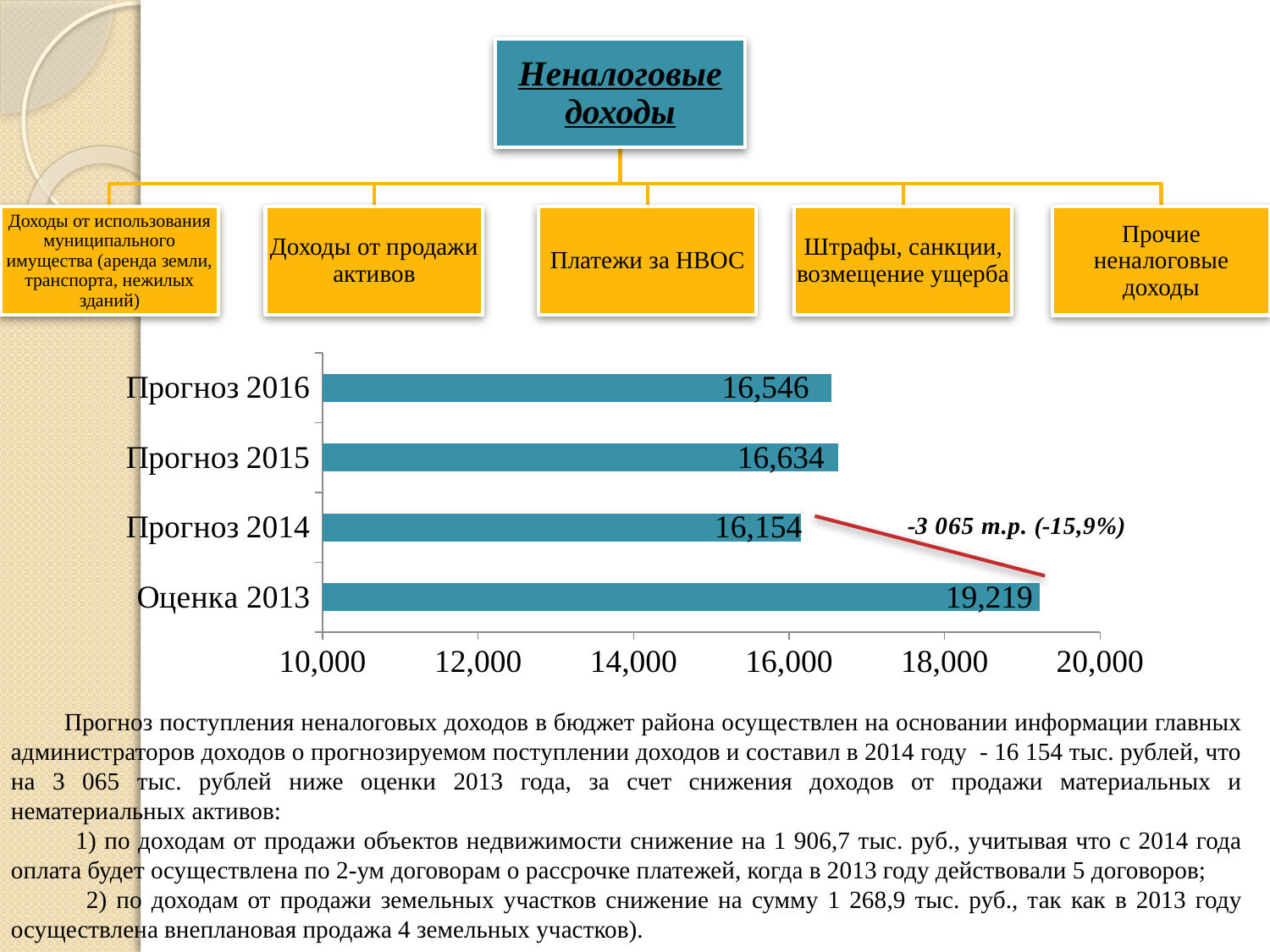
What is the value for Прогноз 2014? 16,154 What is the value for Прогноз 2016? 16,546 What is the difference between the values for Прогноз 2015 and Прогноз 2016? 88 What kind of chart is shown on the slide? bar chart Is the value for Оценка 2013 greater or less than 18,000? greater What is the value for Прогноз 2015? 16,634 Which category has the highest value? Оценка 2013 What is the value for Оценка 2013? 19,219 What is the difference between the values for Оценка 2013 and Прогноз 2014? 3,065 Which category has the lowest value? Прогноз 2014 How many categories are shown in the chart? 4 Which is larger, the value for Прогноз 2015 or the value for Прогноз 2014? Прогноз 2015